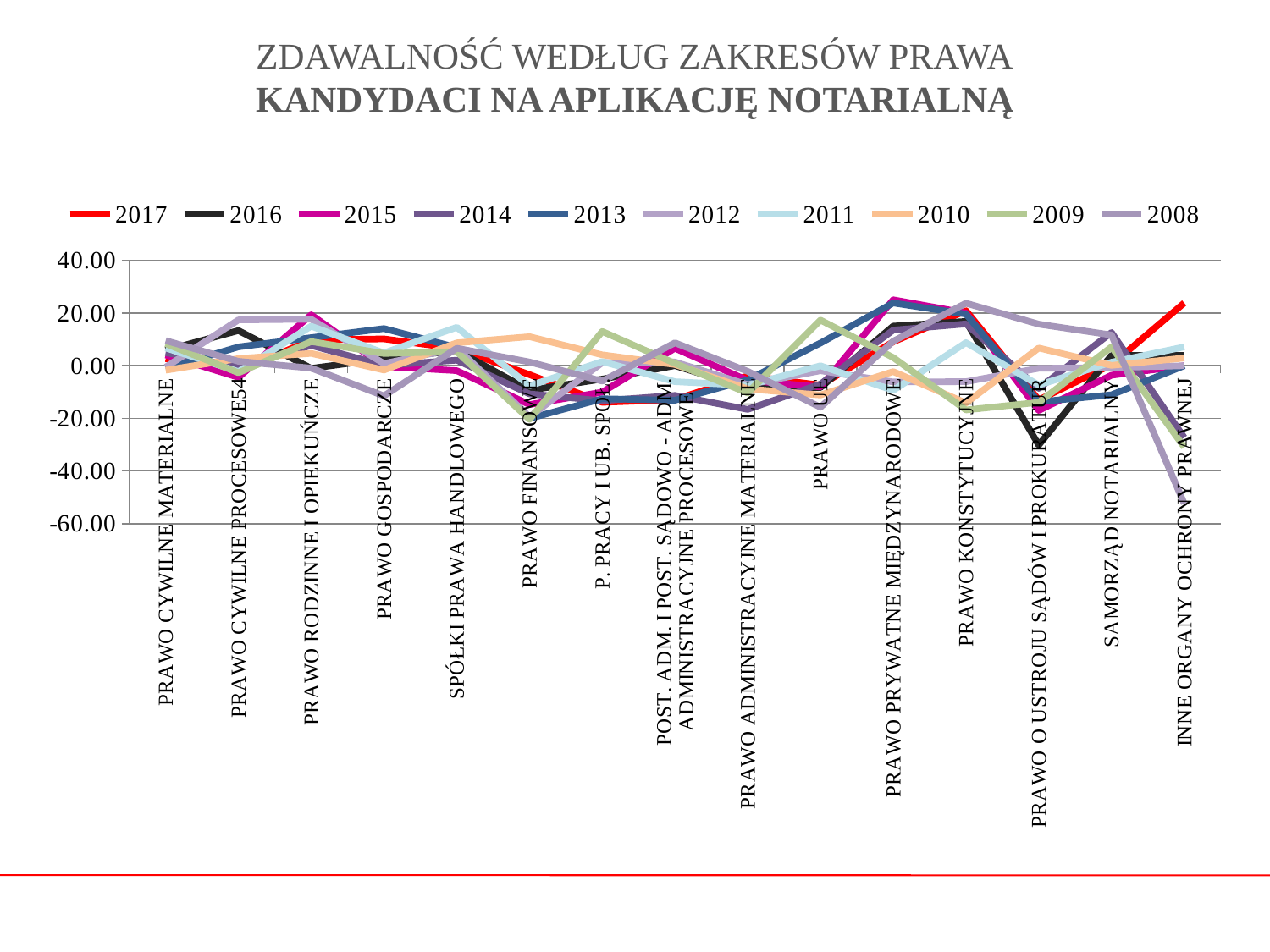
Is the value for 2012 at PRAWO KONSTYTUCYJNE greater or less than 0? less What colour is the line for the 2017 series? red Is the value for 2008 at INNE ORGANY OCHRONY PRAWNEJ greater or less than -20? less Is the value for 2013 at PRAWO PRYWATNE MIĘDZYNARODOWE greater or less than 0? greater How many series does the legend list? 10 Which series has the lowest value at PRAWO O USTROJU SĄDÓW I PROKURATUR? 2016 What kind of chart is shown on the slide? line chart Which series has the lowest value at INNE ORGANY OCHRONY PRAWNEJ? 2008 Which series is listed first in the legend? 2017 How many categories are shown along the x axis? 15